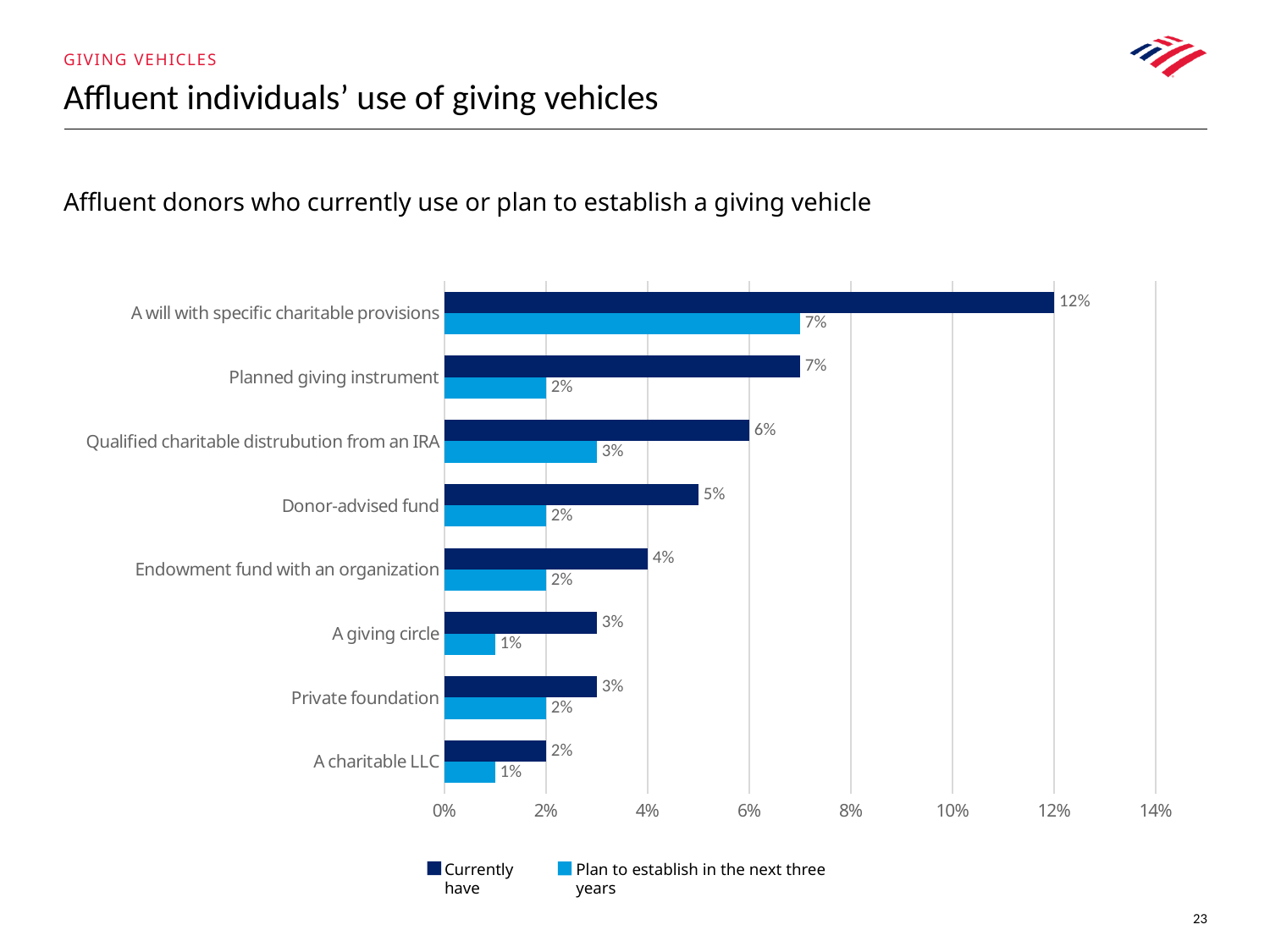
Which giving vehicle has the highest 'Currently have' percentage? A will with specific charitable provisions What is the difference between the 'Currently have' values for A will with specific charitable provisions and Planned giving instrument? 5% How many series does the legend list? 2 What kind of chart is shown on the slide? Bar chart What is the 'Currently have' value for Qualified charitable distrubution from an IRA? 6% Which giving vehicle has the lowest 'Currently have' percentage? A charitable LLC What percentage of affluent donors currently have a will with specific charitable provisions? 12% What is the title of the chart? Affluent donors who currently use or plan to establish a giving vehicle How many giving vehicles are listed on the chart? 8 Which is larger: the 'Currently have' value for Donor-advised fund or for Endowment fund with an organization? Donor-advised fund What percentage of affluent donors plan to establish a donor-advised fund in the next three years? 2% What is the difference between the 'Currently have' and 'Plan to establish in the next three years' values for Planned giving instrument? 5%